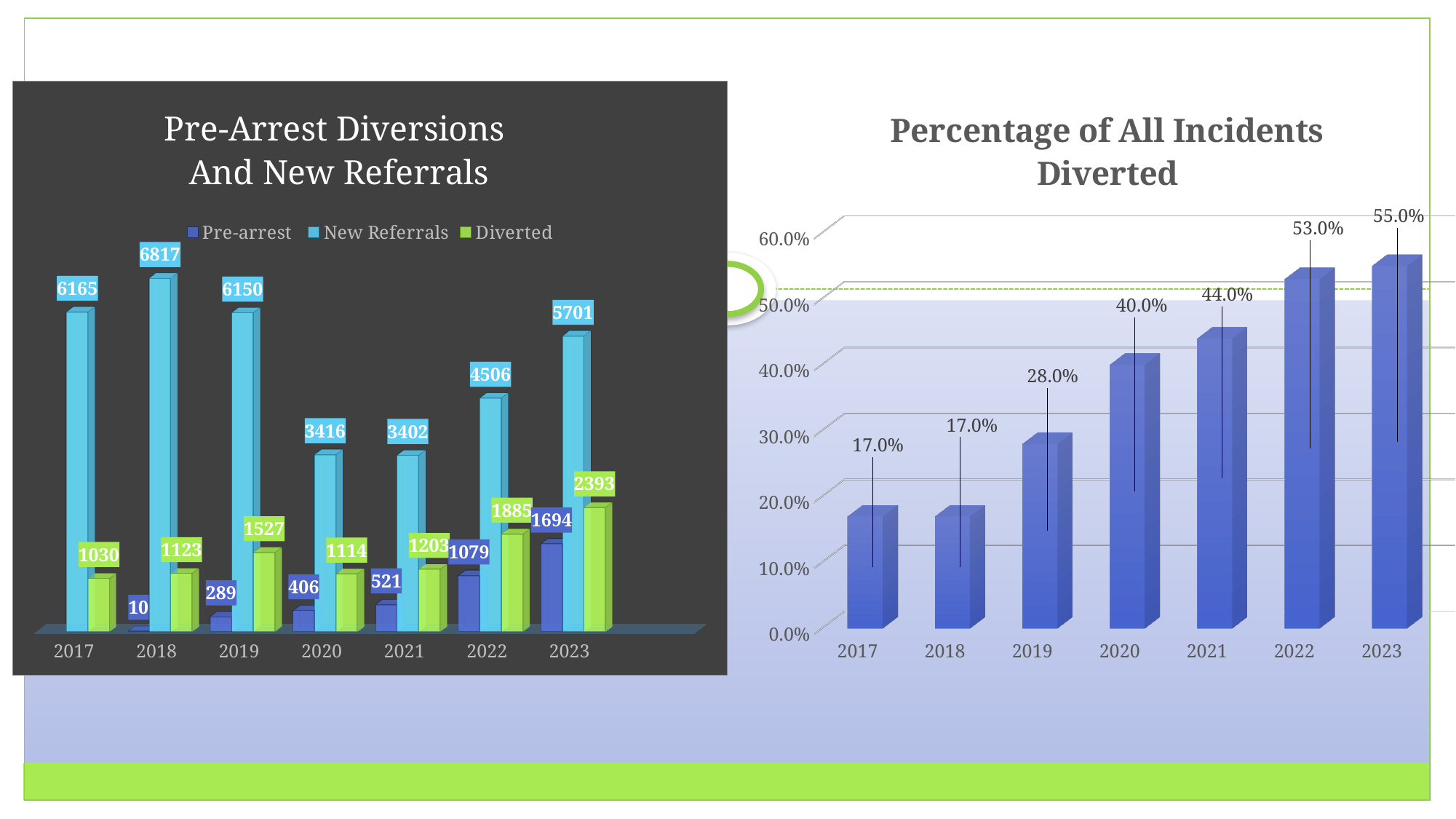
In the 'Percentage of All Incidents Diverted' chart, which year has the highest value? 2023 In the 'Pre-Arrest Diversions And New Referrals' chart, what is the Pre-arrest value for 2021? 521 In the 'Percentage of All Incidents Diverted' chart, what is the difference between the values for 2023 and 2017? 38.0% In the 'Pre-Arrest Diversions And New Referrals' chart, what is the New Referrals value for 2018? 6817 In the 'Pre-Arrest Diversions And New Referrals' chart, what is the Diverted value for 2023? 2393 In the 'Pre-Arrest Diversions And New Referrals' chart, which year has the lowest Pre-arrest value? 2018 In the 'Percentage of All Incidents Diverted' chart, what is the value for 2020? 40.0% In the 'Pre-Arrest Diversions And New Referrals' chart, how many series does the legend list? 3 In the 'Pre-Arrest Diversions And New Referrals' chart, which year has the highest New Referrals value? 2018 In the 'Percentage of All Incidents Diverted' chart, how many years are shown on the x axis? 7 In the 'Pre-Arrest Diversions And New Referrals' chart, what is the difference between the Diverted values for 2022 and 2021? 682 What kind of chart is 'Percentage of All Incidents Diverted'? Bar chart